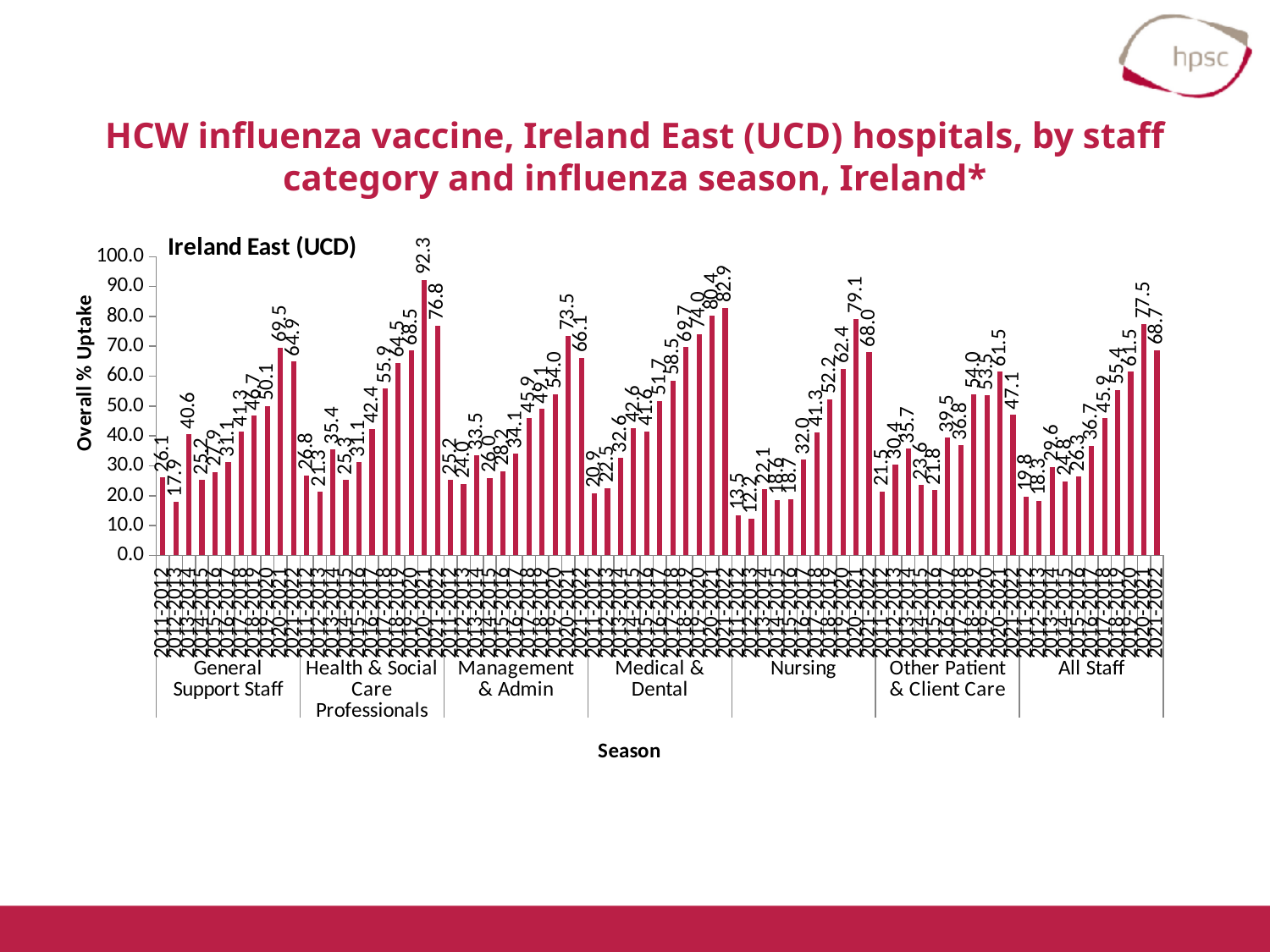
Which staff category contains the lowest bar on the chart, and what is its value? Nursing, 12.2 What is the highest value shown in the All Staff group? 77.5 What is the title printed inside the chart area? Ireland East (UCD) How many staff categories are shown along the x axis? 7 What is the label on the vertical axis? Overall % Uptake What is the highest value shown in the Medical & Dental group? 82.9 In the Nursing group, what is the difference between the highest bar (79.1) and the last bar (68.0)? 11.1 What type of chart is shown on the slide? bar chart How many bars (seasons) are plotted for each staff category? 11 What is the highest value shown in the Other Patient & Client Care group? 61.5 Which staff category contains the highest bar on the chart, and what is its value? Health & Social Care Professionals, 92.3 Which is larger: the last bar in the Medical & Dental group or the last bar in the Nursing group? Medical & Dental